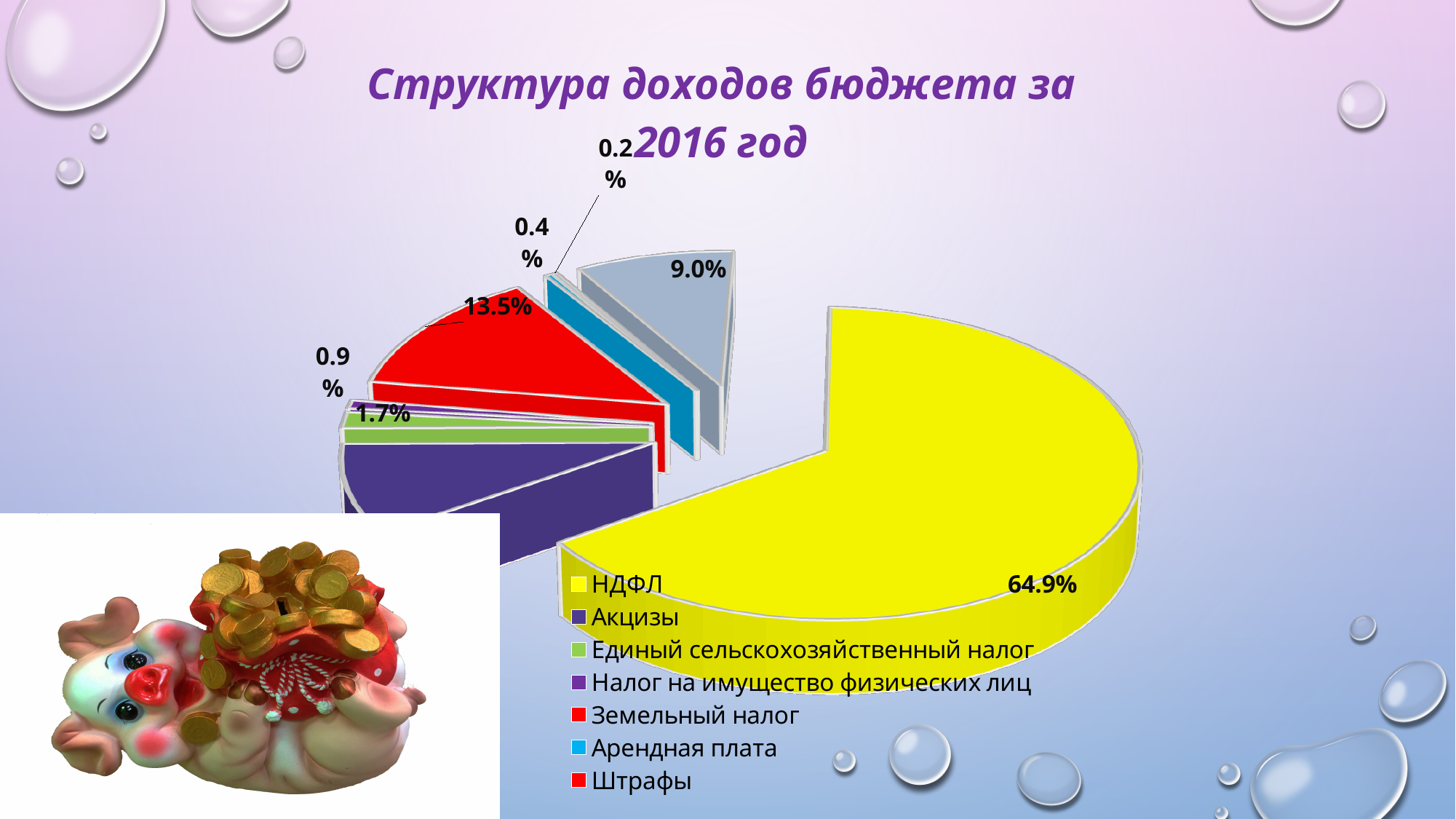
What is the title of the chart? Структура доходов бюджета за 2016 год What is the value shown for Налог на имущество физических лиц? 0.9% What share of the pie does НДФЛ have? 64.9% What type of chart is shown on the slide? pie chart How many entries does the chart legend list? 7 Which is larger, the share for Земельный налог or the share for Единый сельскохозяйственный налог? Земельный налог What is the value shown for Арендная плата? 0.4% What colour is the slice representing НДФЛ? yellow What is the value shown for Земельный налог? 13.5% What is the difference between the НДФЛ share and the Земельный налог share? 51.4% What is the value shown for Единый сельскохозяйственный налог? 1.7% Which category has the largest slice of the pie? НДФЛ